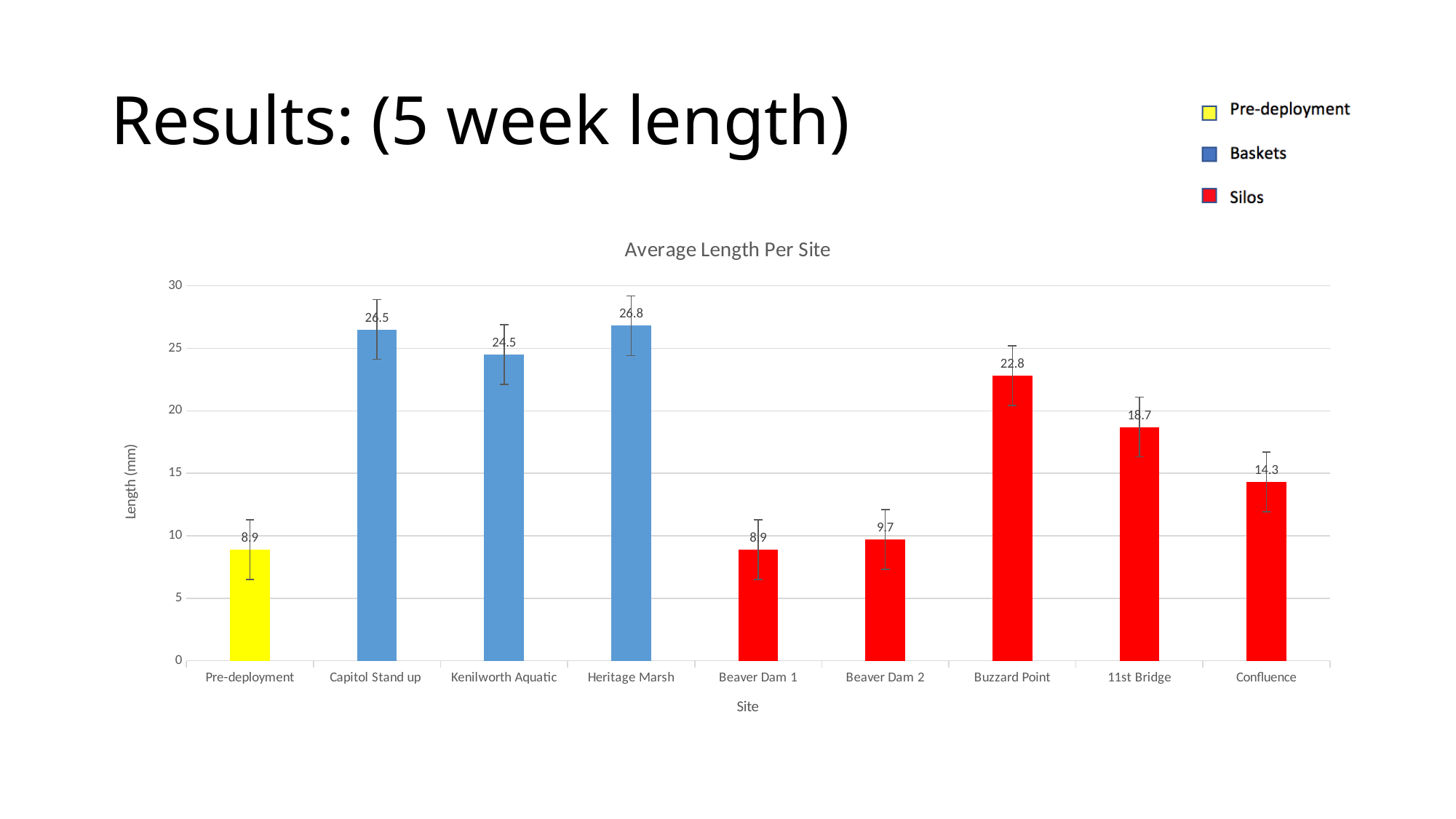
What is the difference between the average length at 11st Bridge and at Confluence? 4.4 What is the average length for Heritage Marsh? 26.8 How many sites are shown on the x axis? 9 What type of chart is shown? Bar chart How many entries does the legend list? 3 What is the difference between the average length at Capitol Stand up and at Kenilworth Aquatic? 2.0 Which has a larger average length, Buzzard Point or 11st Bridge? Buzzard Point Which site has the highest average length? Heritage Marsh What is the average length for Beaver Dam 2? 9.7 What is the average length for Buzzard Point? 22.8 Is the value for Kenilworth Aquatic greater or less than 20? greater What is the average length for Confluence? 14.3